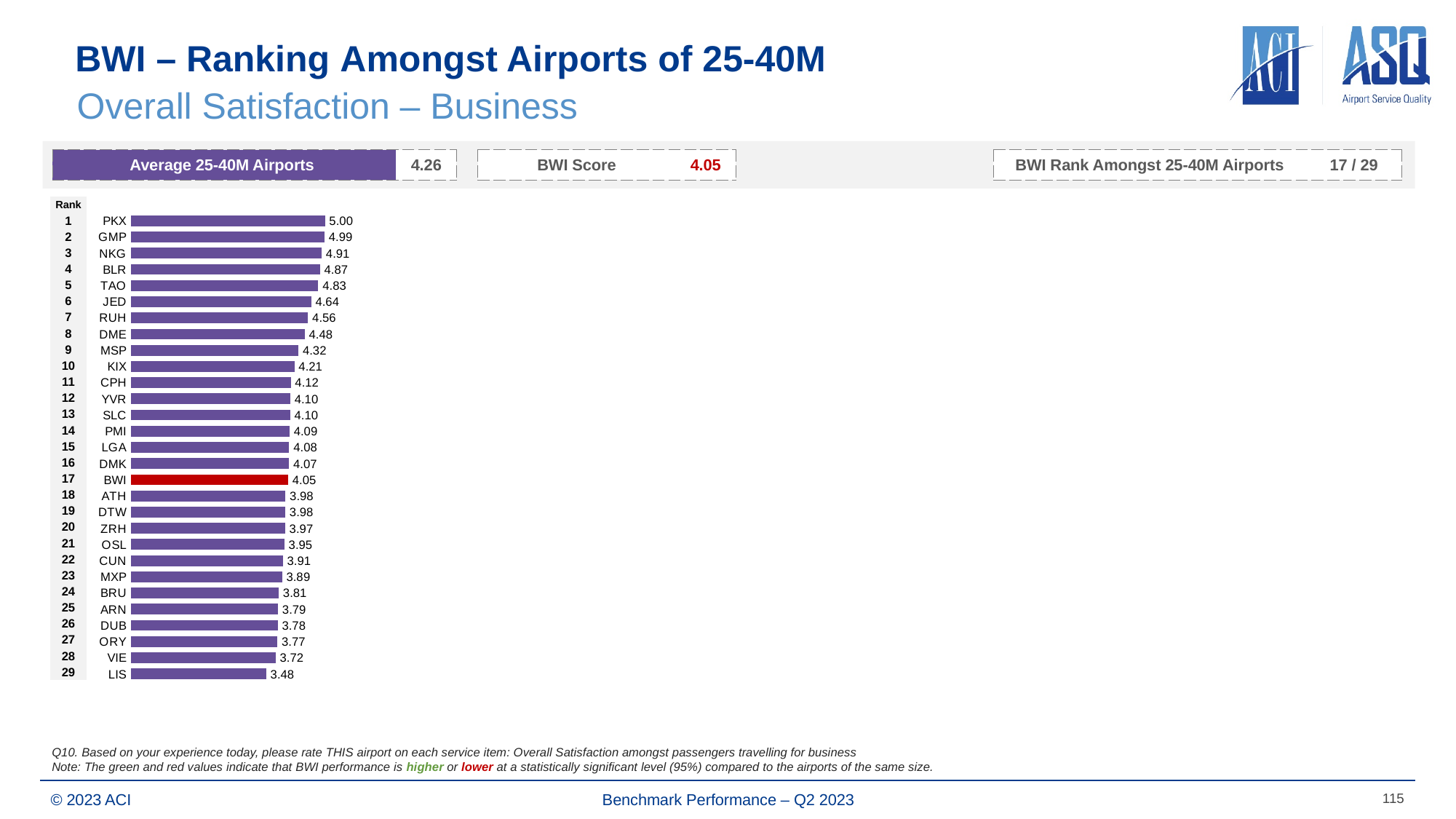
Which has a larger value, JED or DME? JED How many airports are ranked in the chart? 29 What is the value for BWI? 4.05 Which has a larger value, CUN or BRU? CUN Which airport has the highest value? PKX What is the difference between the values for BWI and LIS? 0.57 What is the difference between the values for PKX and BWI? 0.95 Which airport's bar is coloured red in the chart? BWI What is the value for MSP? 4.32 What is the value for LIS? 3.48 What kind of chart is shown on the slide? Bar chart Which airport has the lowest value? LIS